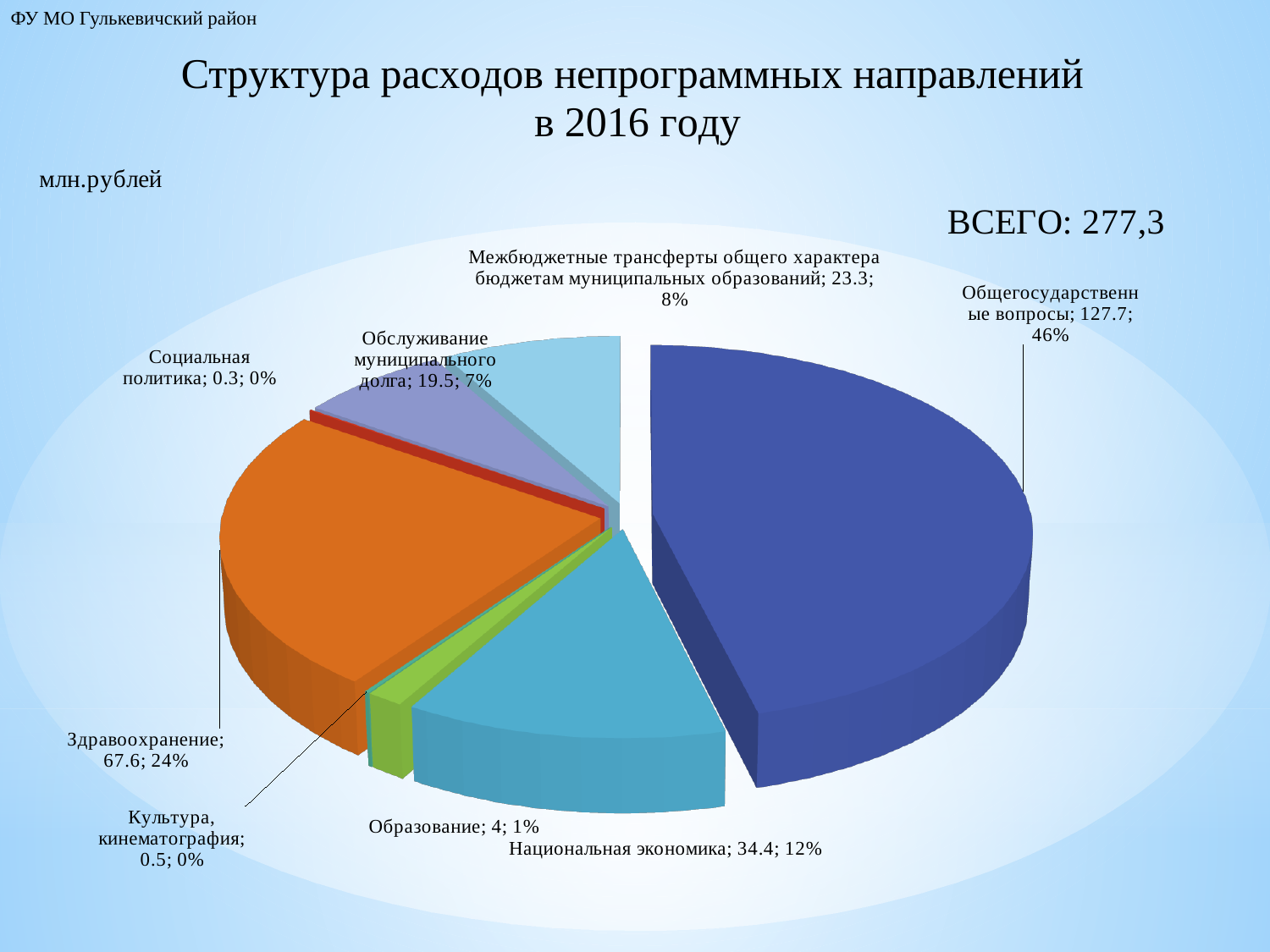
Which category has the smallest value? Социальная политика What is the difference between the values for Общегосударственные вопросы and Здравоохранение? 60.1 Which is larger, the value for Национальная экономика or the value for Межбюджетные трансферты общего характера бюджетам муниципальных образований? Национальная экономика What is the value for Общегосударственные вопросы? 127.7 What share of the pie does Обслуживание муниципального долга have? 7% What total (ВСЕГО) is stated on the slide? 277,3 What is the value for Национальная экономика? 34.4 What share of the pie does Межбюджетные трансферты общего характера бюджетам муниципальных образований have? 8% What type of chart is shown on the slide? pie chart What is the value for Здравоохранение? 67.6 How many categories does the pie chart show? 8 Which category has the largest slice of the pie? Общегосударственные вопросы